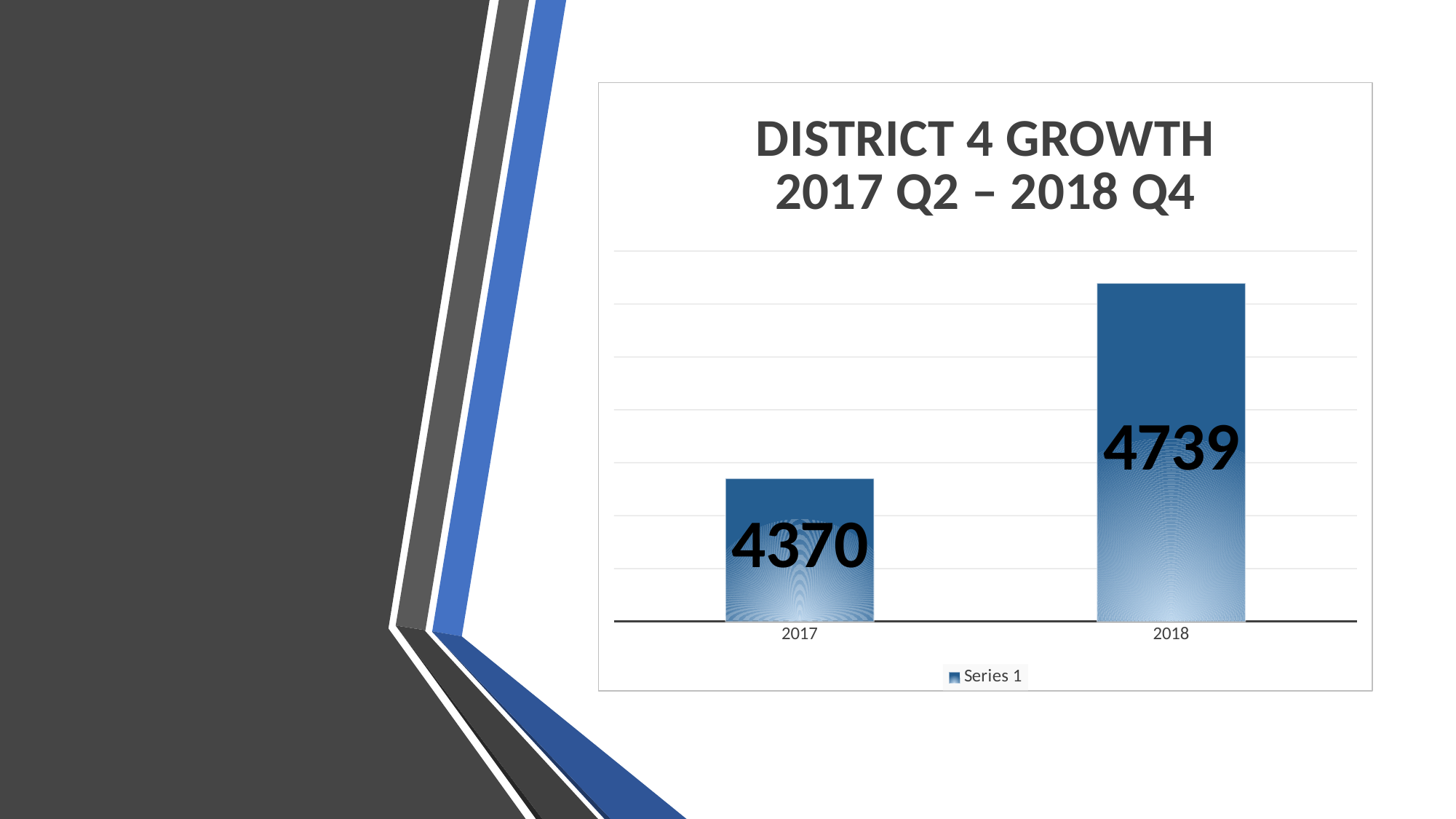
What is the name of the series listed in the legend? Series 1 Which year has the lowest value? 2017 How many series does the legend list? 1 What is the value for 2017? 4370 What is the difference between the values for 2018 and 2017? 369 Which is larger, the value for 2017 or the value for 2018? 2018 Which year has the highest value? 2018 How many categories are shown on the x axis? 2 What is the title of the chart? DISTRICT 4 GROWTH 2017 Q2 – 2018 Q4 What is the value for 2018? 4739 Do the values rise or fall from 2017 to 2018? rise What kind of chart is shown? bar chart